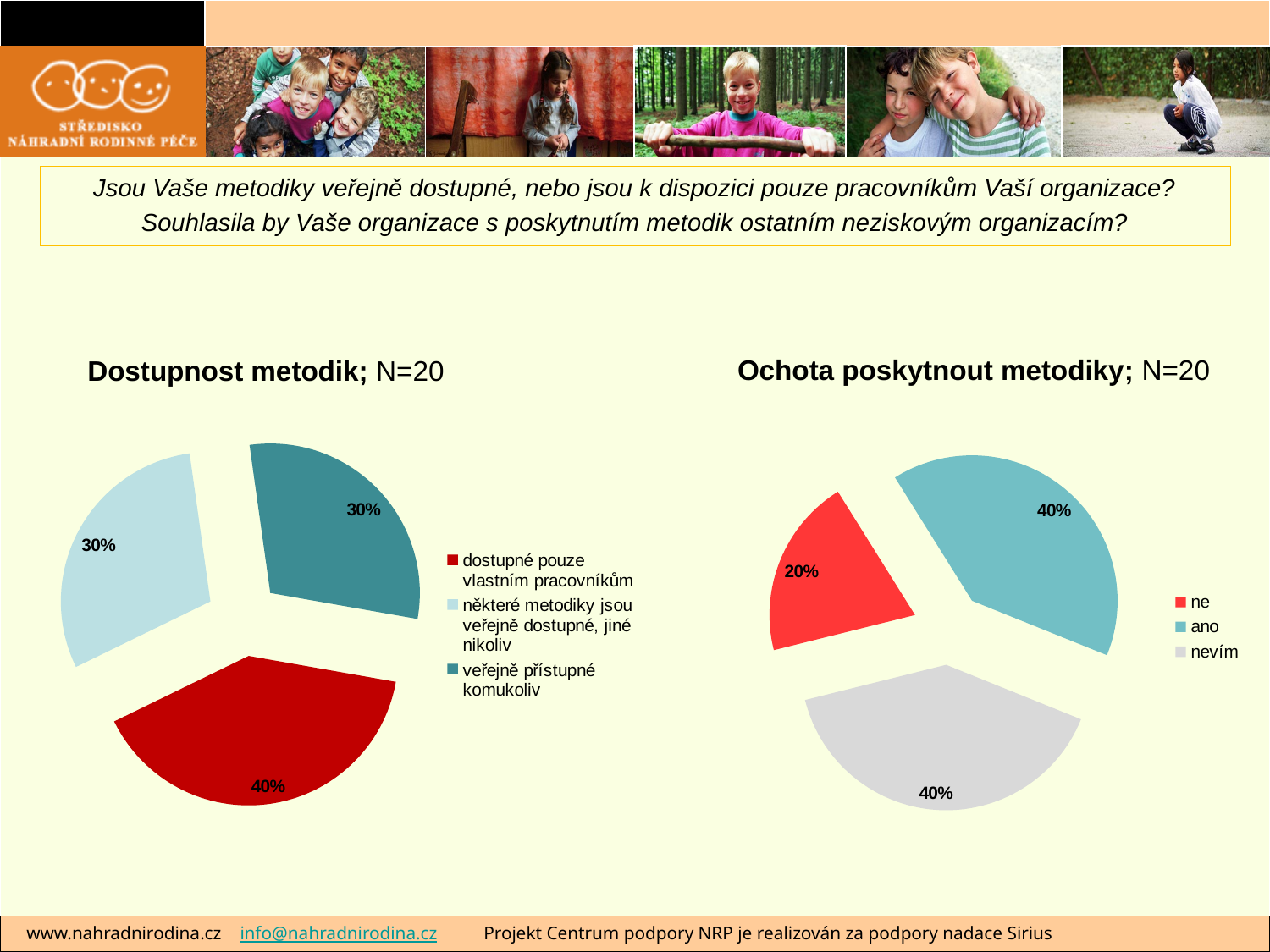
In the 'Ochota poskytnout metodiky' chart, which category has the smallest slice? ne In the 'Dostupnost metodik' chart, which category has the largest slice? dostupné pouze vlastním pracovníkům What kind of chart is 'Dostupnost metodik'? pie chart How many entries does the legend of the 'Ochota poskytnout metodiky' chart list? 3 In the 'Ochota poskytnout metodiky' chart, what share is 'ne'? 20% In the 'Dostupnost metodik' chart, what share is 'dostupné pouze vlastním pracovníkům'? 40% In the 'Ochota poskytnout metodiky' chart, what colour is the 'ne' slice? red In the 'Ochota poskytnout metodiky' chart, what share is 'ano'? 40% In the 'Ochota poskytnout metodiky' chart, which is larger, 'nevím' or 'ne'? nevím In the 'Ochota poskytnout metodiky' chart, what is the difference between the 'ano' and 'ne' shares? 20% In the 'Dostupnost metodik' chart, how many slices does the pie have? 3